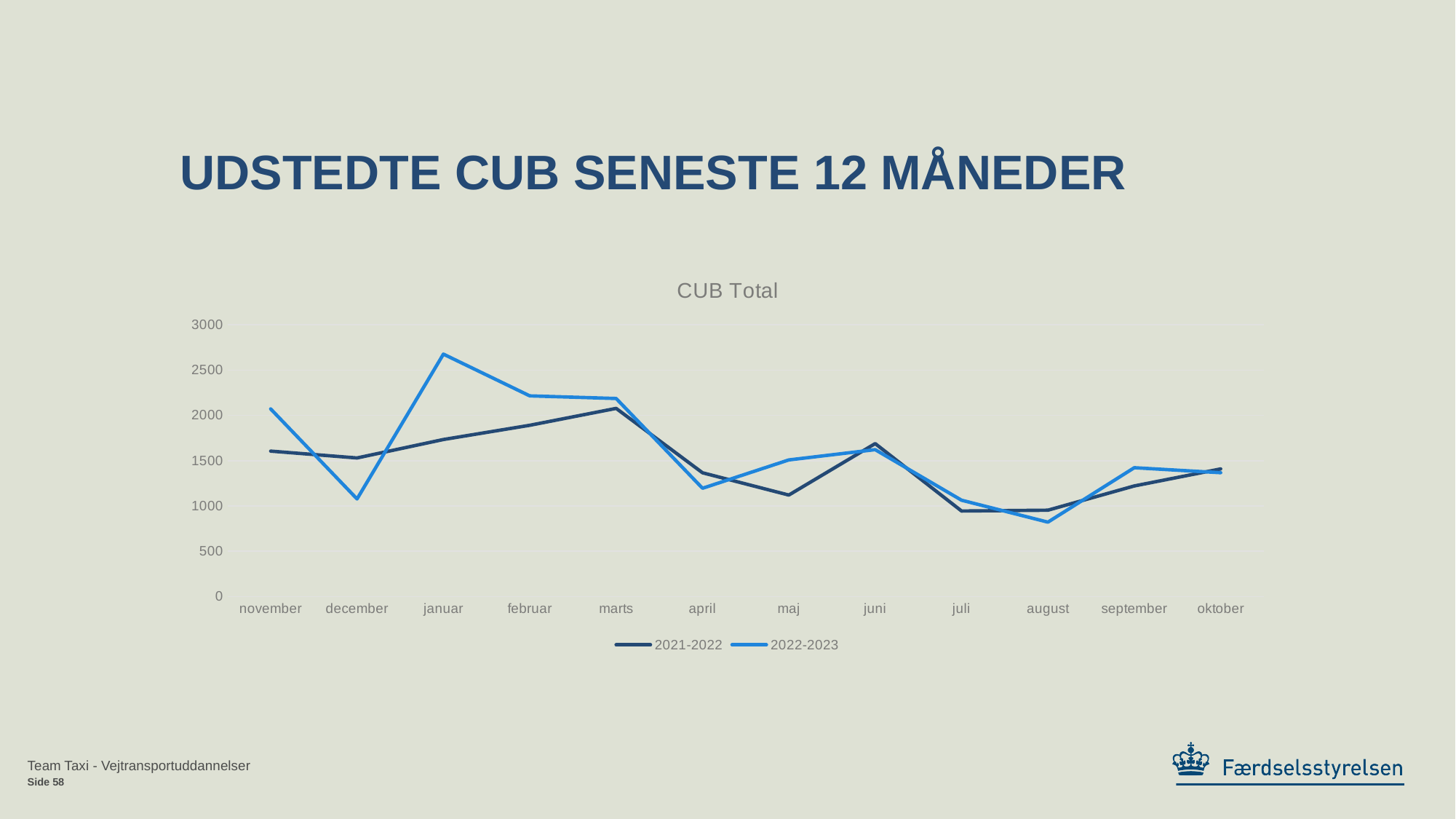
Is the value for 2022-2023 in august greater or less than 1000? less In which month does the 2021-2022 series reach its highest value? marts In which month does the 2022-2023 series reach its lowest value? august How many months are shown on the x axis? 12 Is the value for 2022-2023 in december greater or less than 1500? less In which month does the 2022-2023 series reach its highest value? januar In januar, which series has the higher value, 2021-2022 or 2022-2023? 2022-2023 How many series does the legend list? 2 What kind of chart is shown on the slide? line chart Is the value for 2022-2023 in januar greater or less than 2500? greater In maj, which series has the higher value, 2021-2022 or 2022-2023? 2022-2023 What is the title of the chart? CUB Total